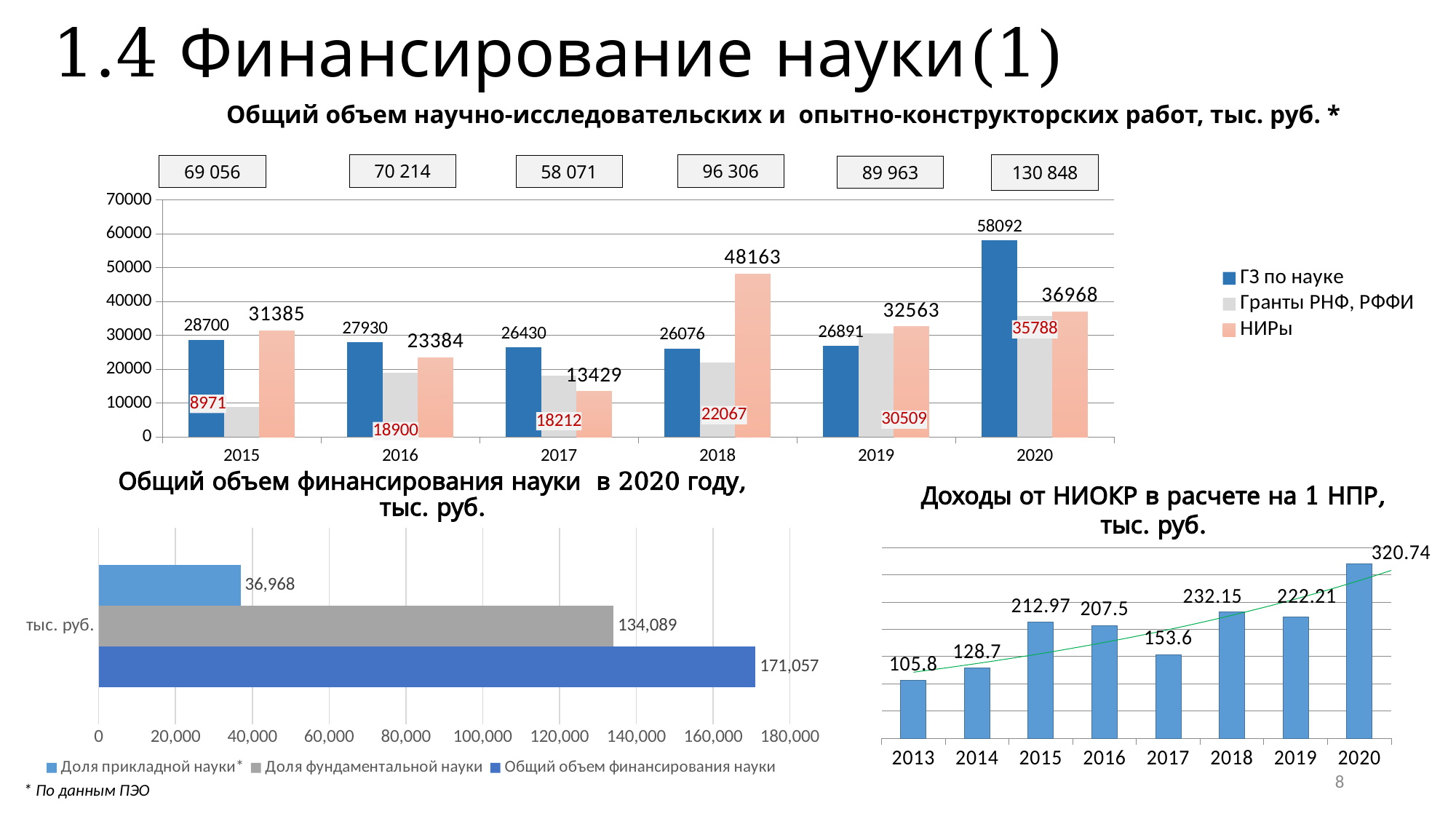
In the bottom-left chart 'Общий объем финансирования науки в 2020 году', what is the difference between Доля фундаментальной науки and Доля прикладной науки? 97,121 What kind of chart is the bottom-left chart 'Общий объем финансирования науки в 2020 году'? Bar chart In the top chart 'Общий объем научно-исследовательских и опытно-конструкторских работ', what is the difference between НИРы and Гранты РНФ, РФФИ in 2015? 22414 In the bottom-right chart 'Доходы от НИОКР в расчете на 1 НПР', which year has the lowest value? 2013 In the top chart 'Общий объем научно-исследовательских и опытно-конструкторских работ', what is the value of НИРы in 2018? 48163 In the top chart 'Общий объем научно-исследовательских и опытно-конструкторских работ', in which year is the ГЗ по науке value highest? 2020 In the top chart 'Общий объем научно-исследовательских и опытно-конструкторских работ', how many series does the legend list? 3 In the top chart 'Общий объем научно-исследовательских и опытно-конструкторских работ', what total is shown in the box above 2020? 130 848 In the bottom-right chart 'Доходы от НИОКР в расчете на 1 НПР', what is the value for 2017? 153.6 In the top chart 'Общий объем научно-исследовательских и опытно-конструкторских работ', which is larger in 2017: Гранты РНФ, РФФИ or НИРы? Гранты РНФ, РФФИ In the bottom-left chart 'Общий объем финансирования науки в 2020 году', what is the value for Общий объем финансирования науки? 171,057 In the top chart 'Общий объем научно-исследовательских и опытно-конструкторских работ', what is the value of ГЗ по науке in 2020? 58092